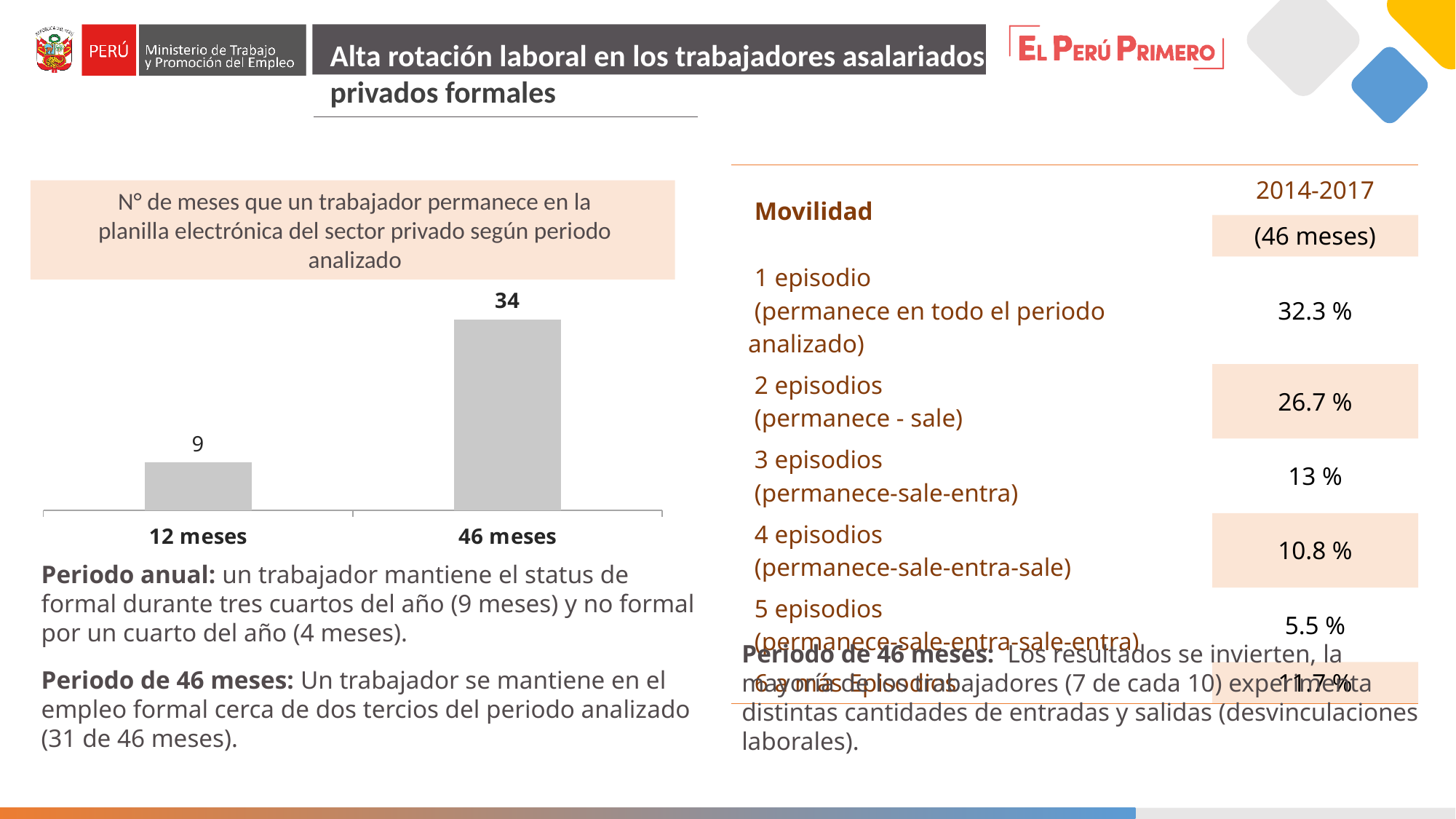
Which category has the highest value in the bar chart? 46 meses How many categories are shown in the bar chart? 2 What is the value for "46 meses" in the bar chart? 34 What is the value for "12 meses" in the bar chart? 9 Do the values rise or fall from "12 meses" to "46 meses"? rise What kind of chart is shown on the slide? bar chart What is the title of the bar chart? N° de meses que un trabajador permanece en la planilla electrónica del sector privado según periodo analizado Which is larger, the value for "12 meses" or the value for "46 meses"? 46 meses What is the difference between the values for "46 meses" and "12 meses"? 25 Which category has the lowest value in the bar chart? 12 meses What colour are the bars in the chart? grey